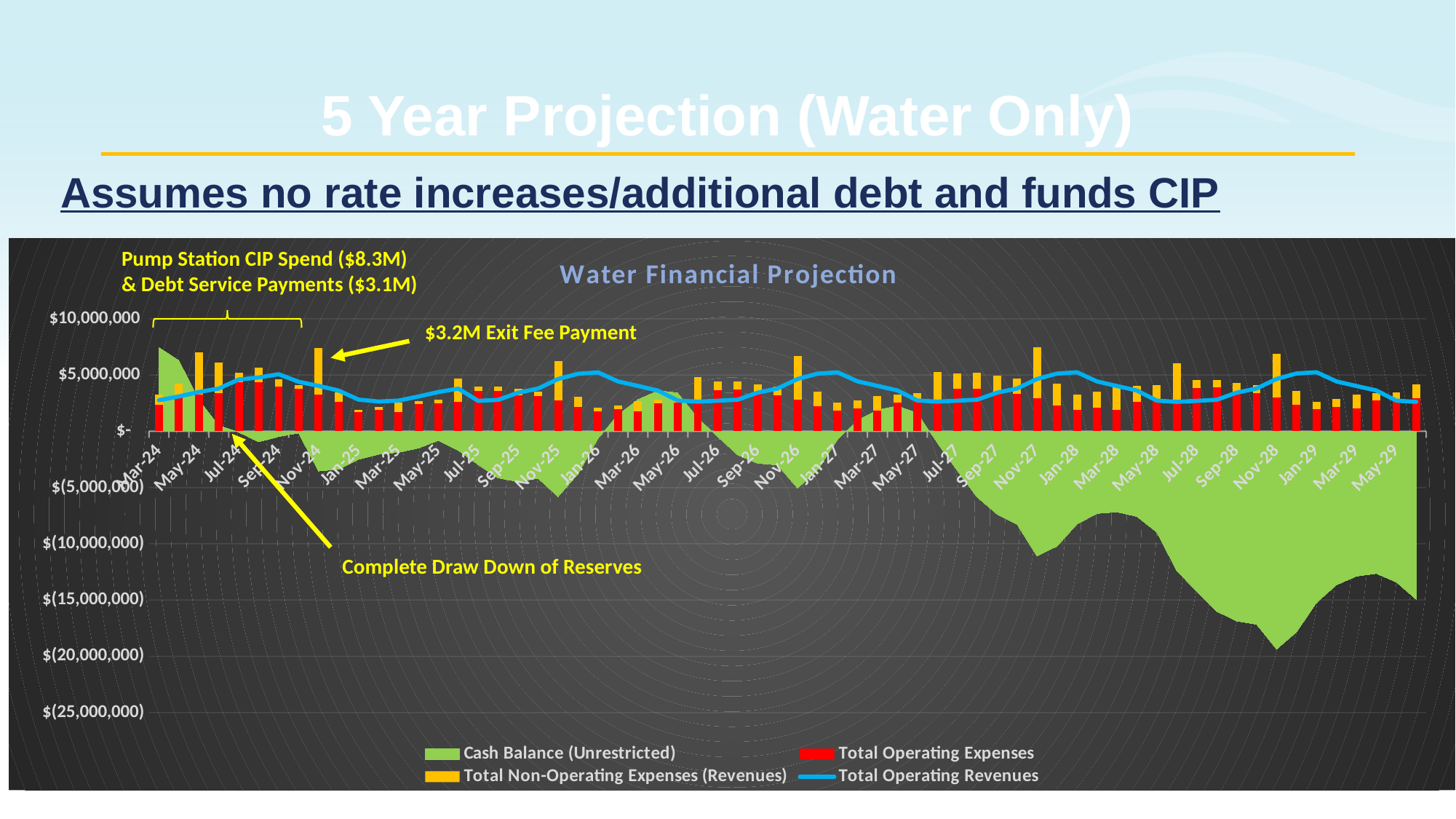
How many series does the chart legend list? 4 According to the annotation, how much is the Exit Fee Payment? $3.2M How many month labels are shown along the x axis? 32 Is the Cash Balance (Unrestricted) at Jan-28 greater or less than $(10,000,000)? greater What is the lowest value shown on the vertical axis? $(25,000,000) Is the Total Operating Revenues value at Mar-24 greater or less than $5,000,000? less What is the title of the chart? Water Financial Projection Which series is shown as a blue line? Total Operating Revenues Is the Cash Balance (Unrestricted) at Nov-28 greater or less than $(15,000,000)? less Does the Cash Balance (Unrestricted) rise or fall overall from Mar-24 to May-29? fall Which is larger, the Cash Balance (Unrestricted) at Mar-24 or at May-29? Mar-24